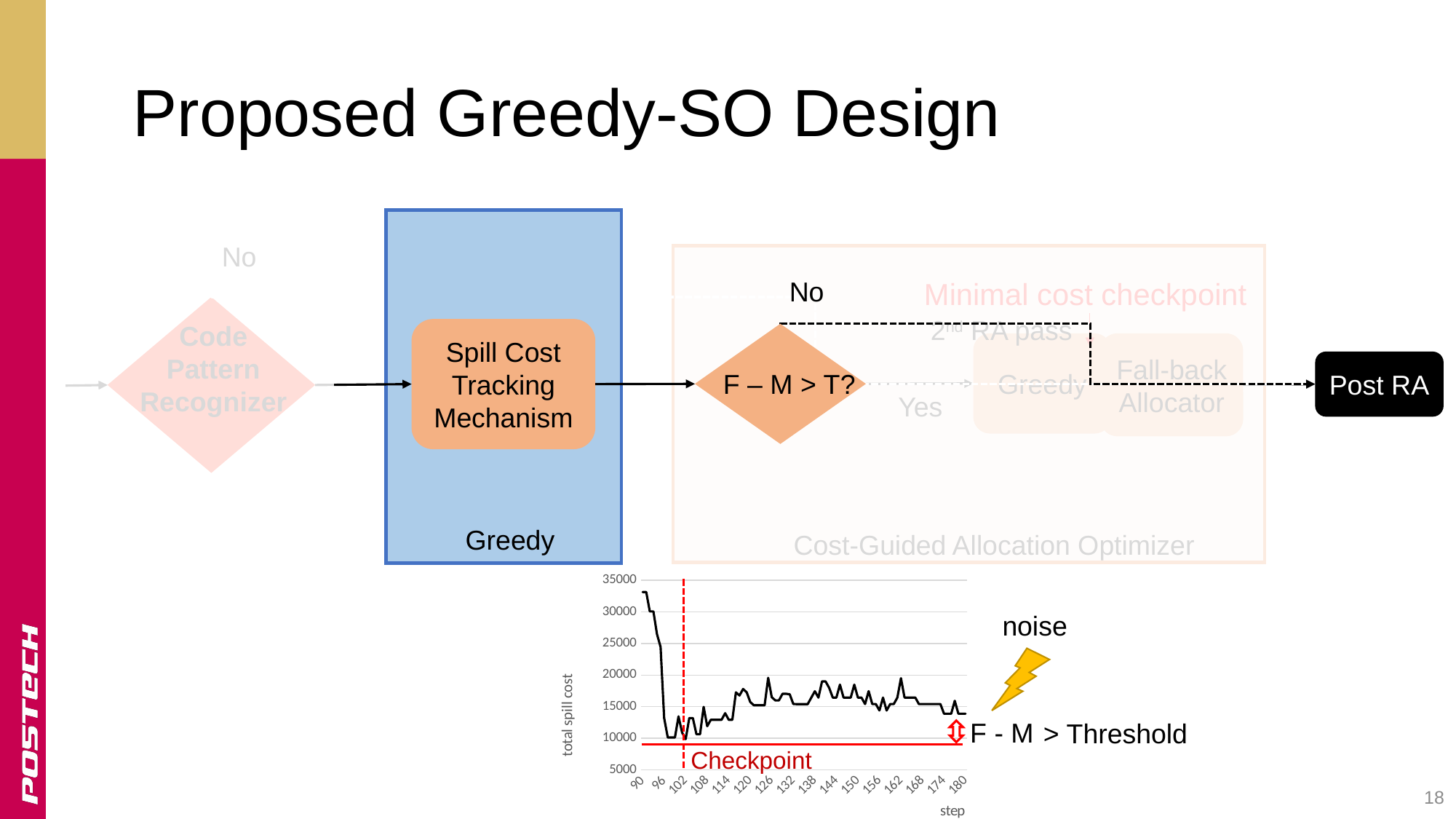
How many tick labels are shown on the x axis of the chart? 16 What kind of chart is shown at the bottom of the slide? line chart What is the label of the x axis of the chart? step Is the total spill cost at step 90 greater or less than 30000? greater What is the highest value shown on the y axis of the chart? 35000 Does the total spill cost rise or fall between step 90 and step 102? fall Is the total spill cost at step 180 greater or less than 10000? greater What is the label of the y axis of the chart? total spill cost Which step has a higher total spill cost, step 90 or step 150? step 90 Is the total spill cost at step 102 greater or less than 15000? less